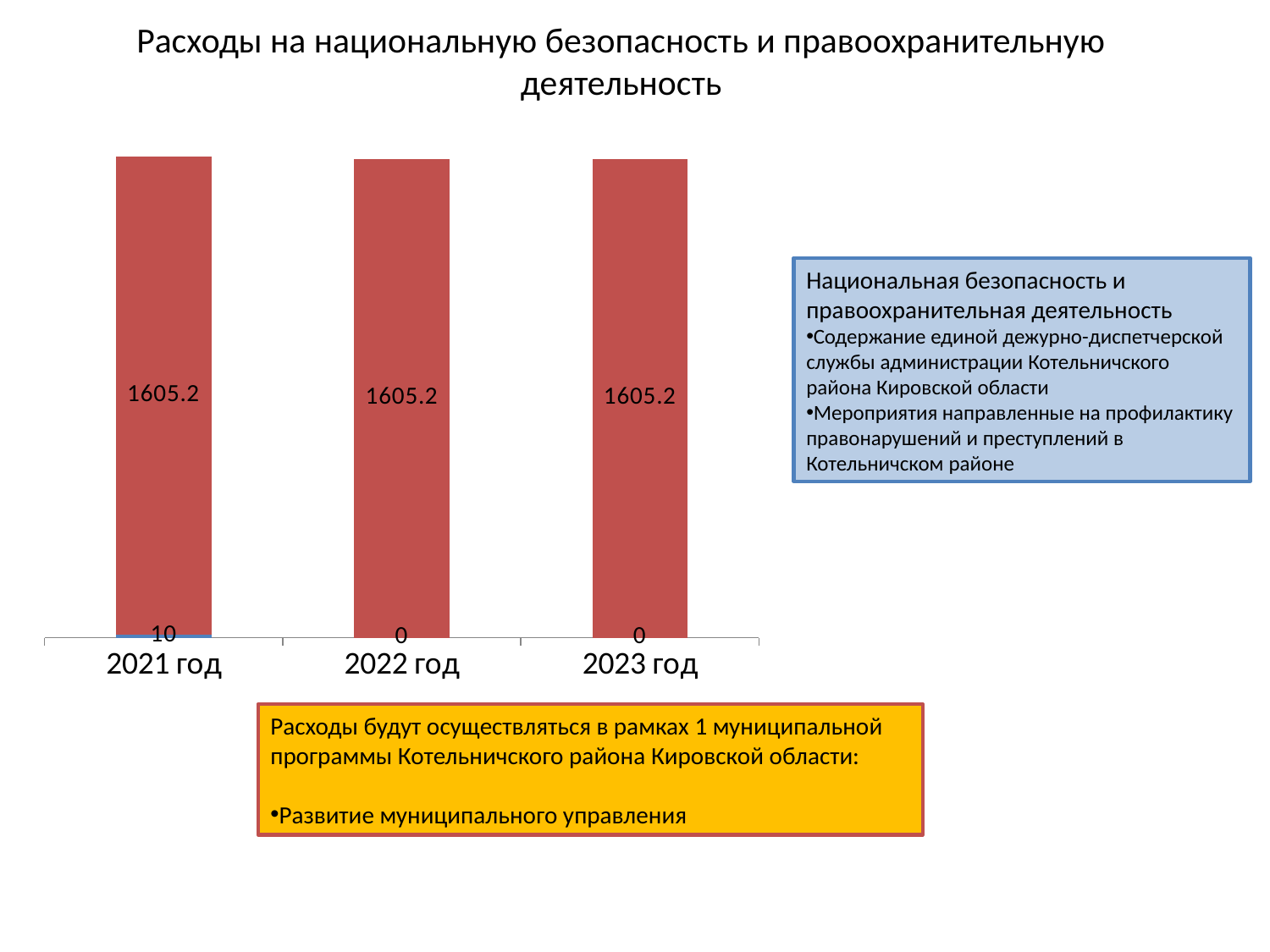
What is the difference between the blue segment value for 2021 год and for 2022 год? 10 What kind of chart is shown on the slide? bar chart What is the value printed on the red bar for 2023 год? 1605.2 What colour are the large bars in the chart? red How many year categories are shown on the x axis? 3 What is the title of the chart? Расходы на национальную безопасность и правоохранительную деятельность Which year has a larger blue segment value, 2021 год or 2023 год? 2021 год What is the value printed on the red bar for 2021 год? 1605.2 What value is printed at the base of the 2021 год bar for the blue segment? 10 Do the red bar values rise, fall, or stay the same from 2021 год to 2023 год? stay the same What is the total of the 2021 год stacked bar (red plus blue segments)? 1615.2 What value is printed at the base of the 2022 год bar? 0